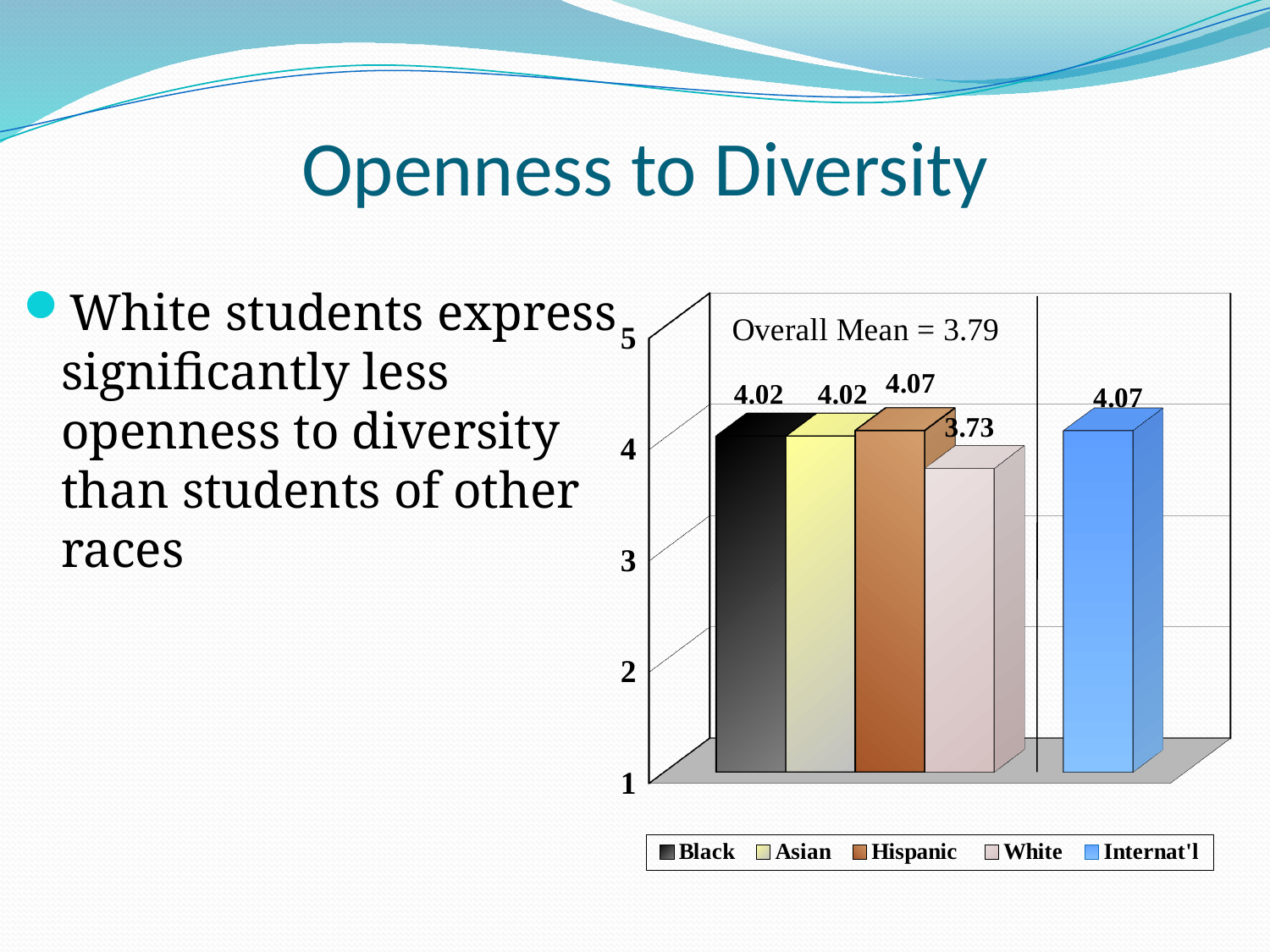
Which is larger, the value for Asian students or the value for White students? Asian What is the difference between the Hispanic value and the White value? 0.34 What is the value for White students in the chart? 3.73 How many groups are shown in the chart legend? 5 What is the value for Internat'l students in the chart? 4.07 What is the value for Black students in the chart? 4.02 Is the value for White students greater or less than 4? less What overall mean is stated on the chart? 3.79 Which group has the lowest value in the chart? White What is the difference between the Black value and the White value? 0.29 What is the value for Hispanic students in the chart? 4.07 What kind of chart is shown on the slide? bar chart